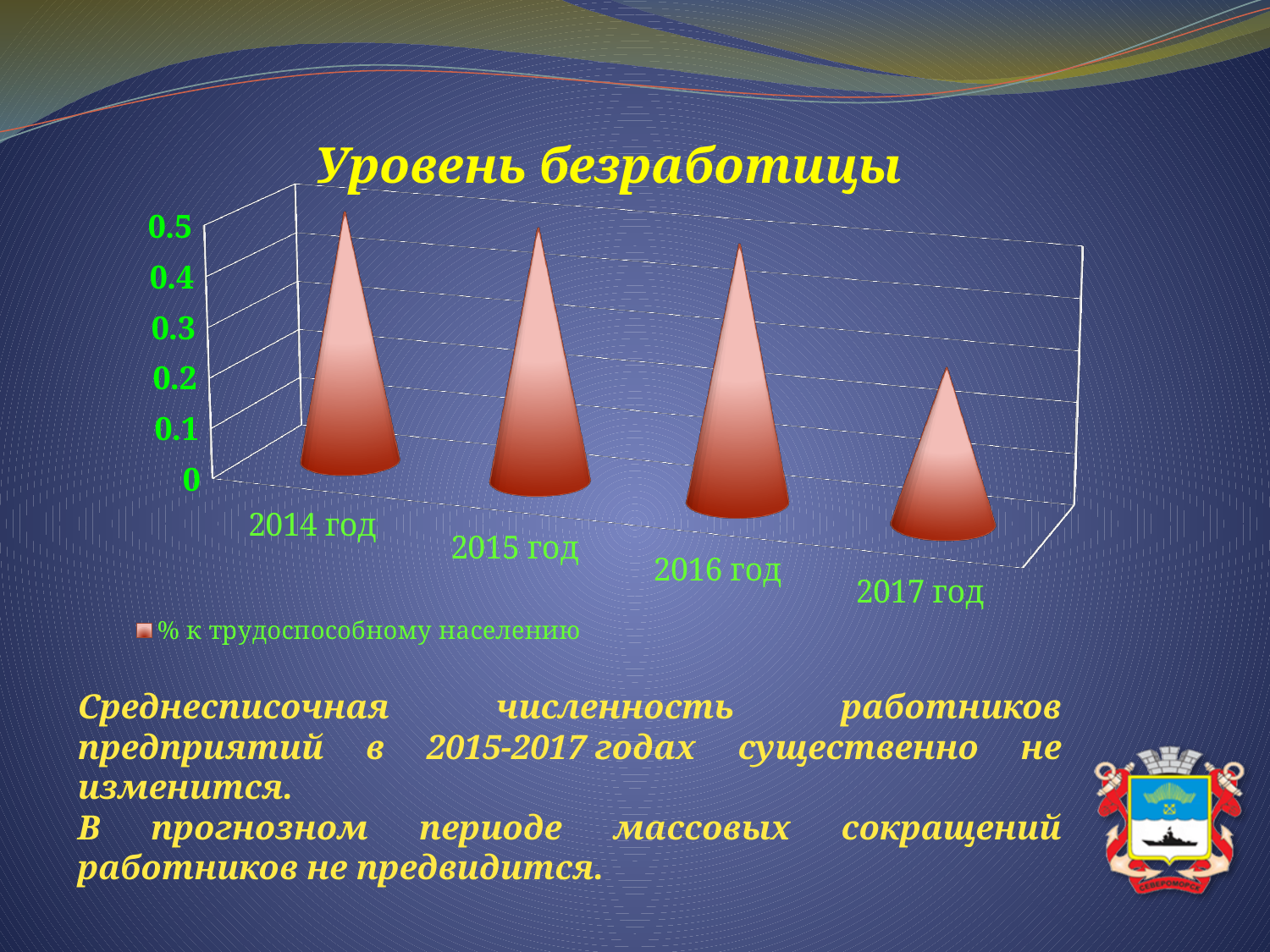
What kind of chart is shown on the slide? bar chart Is the value for 2016 год greater or less than 0.3? greater Which year has the lowest unemployment level in the chart? 2017 год What series does the chart legend list? % к трудоспособному населению Is the value for 2017 год greater or less than 0.2? greater Is the value for 2017 год greater or less than 0.4? less Which is larger, the value for 2014 год or the value for 2017 год? 2014 год How many years are shown on the x axis of the chart? 4 What is the title of the chart? Уровень безработицы How many series does the legend list? 1 Do the values rise or fall from 2014 год to 2017 год? fall